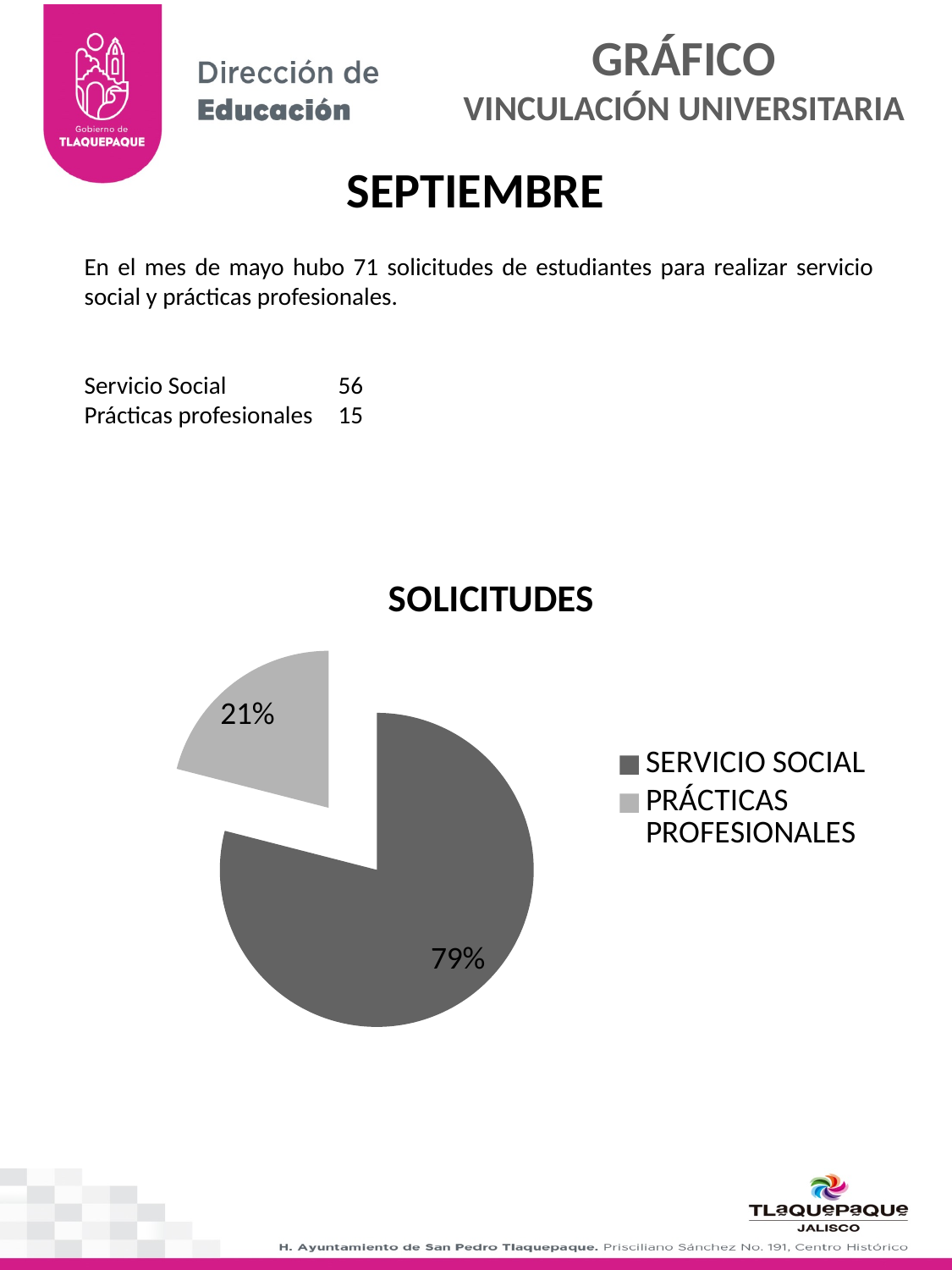
Which category has the smallest slice of the pie? PRÁCTICAS PROFESIONALES What kind of chart is shown on the slide? pie chart Which category has the largest slice of the pie? SERVICIO SOCIAL What is the title of the chart? SOLICITUDES How many entries does the legend list? 2 What share of the pie does SERVICIO SOCIAL represent? 79% What is the difference in percentage points between the SERVICIO SOCIAL slice and the PRÁCTICAS PROFESIONALES slice? 58% Which legend entry is shown in the lighter grey colour? PRÁCTICAS PROFESIONALES How many slices does the pie chart have? 2 What share of the pie does PRÁCTICAS PROFESIONALES represent? 21% Which is larger, the slice for SERVICIO SOCIAL or the slice for PRÁCTICAS PROFESIONALES? SERVICIO SOCIAL